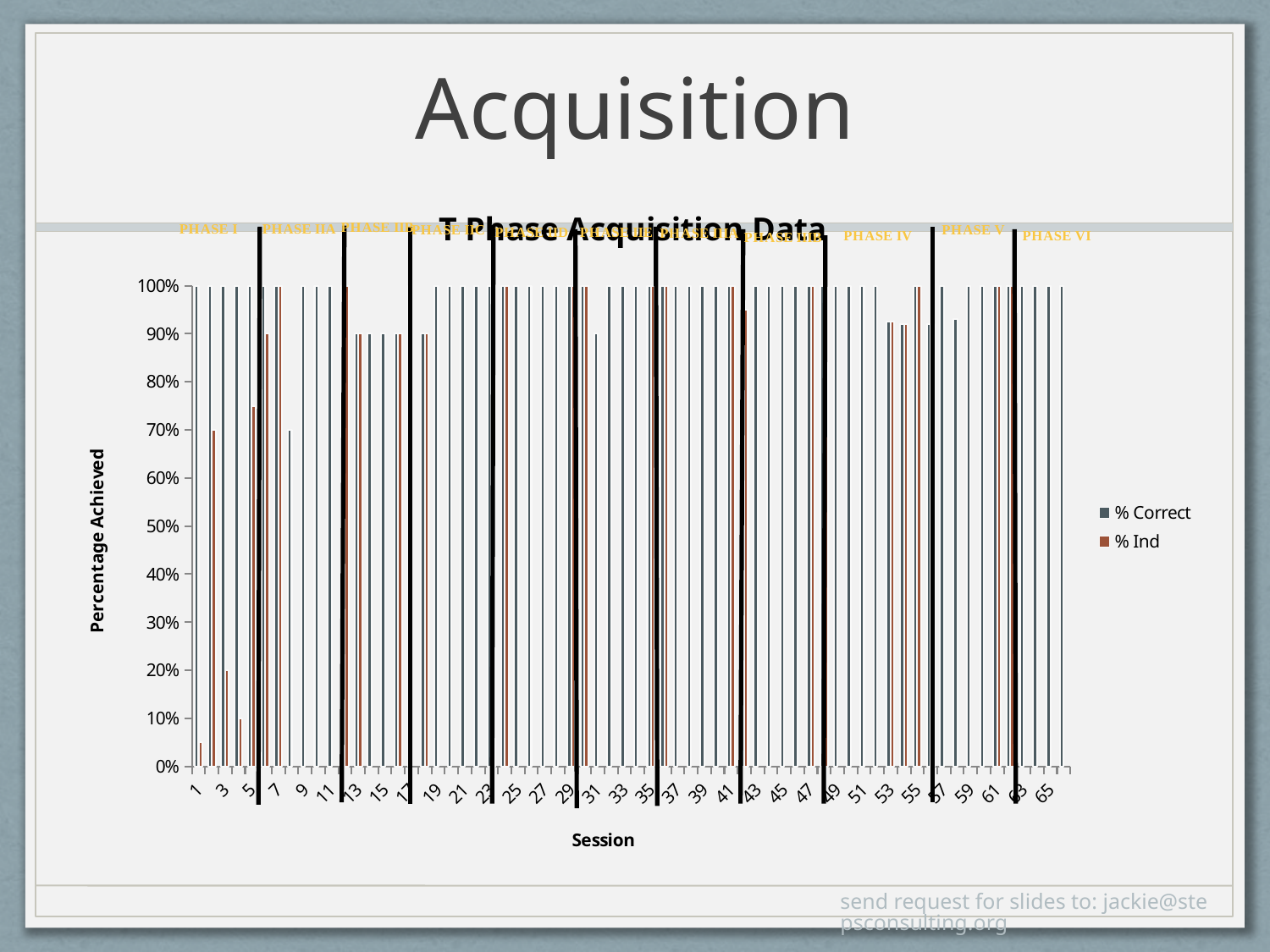
Is the % Ind value for session 1 greater or less than 10%? less Is the % Ind value for session 5 greater or less than 50%? greater What is the x-axis title of the chart? Session Is the % Correct value for session 9 greater or less than 90%? greater How many series does the legend of the chart list? 2 What are the two series named in the chart legend? % Correct and % Ind For session 1, which is larger, % Correct or % Ind? % Correct What is the y-axis title of the chart? Percentage Achieved What is the title of the chart? T Phase Acquisition Data What kind of chart is shown on the slide? bar chart What is the % Correct value for session 1? 100% What is the highest value shown on the y-axis of the chart? 100%